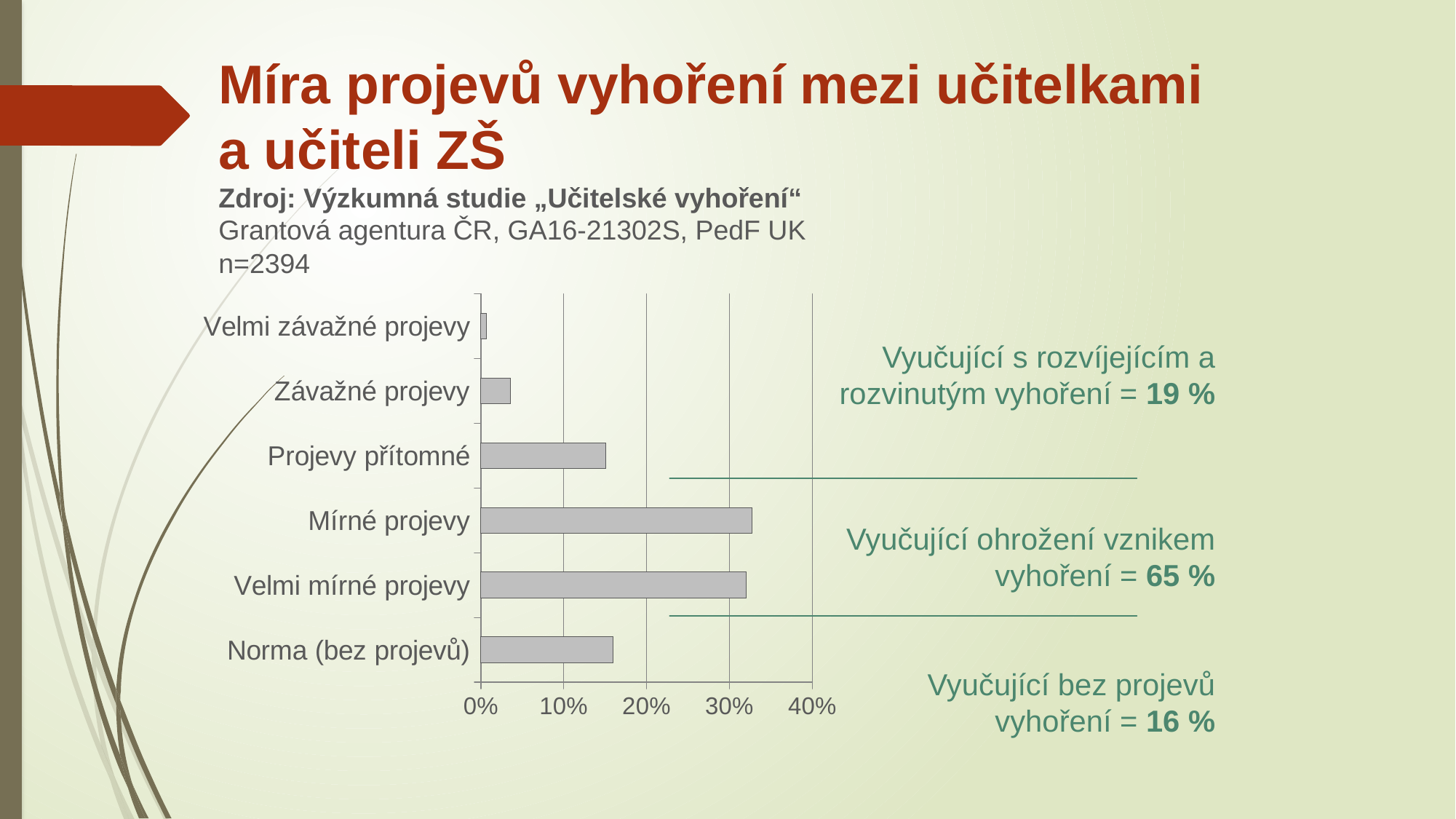
Is the value for Velmi mírné projevy greater or less than 30%? greater What kind of chart is shown on the slide? bar chart How many categories does the chart show? 6 What is the highest value shown on the chart's horizontal axis? 40% Which is larger, the value for Norma (bez projevů) or the value for Závažné projevy? Norma (bez projevů) Is the value for Závažné projevy greater or less than 10%? less Which category has the lowest value in the chart? Velmi závažné projevy Which is larger, the value for Mírné projevy or the value for Projevy přítomné? Mírné projevy Is the value for Mírné projevy greater or less than 30%? greater According to the annotation next to the chart, what percentage of teachers are at risk of developing burnout (Vyučující ohrožení vznikem vyhoření)? 65 %